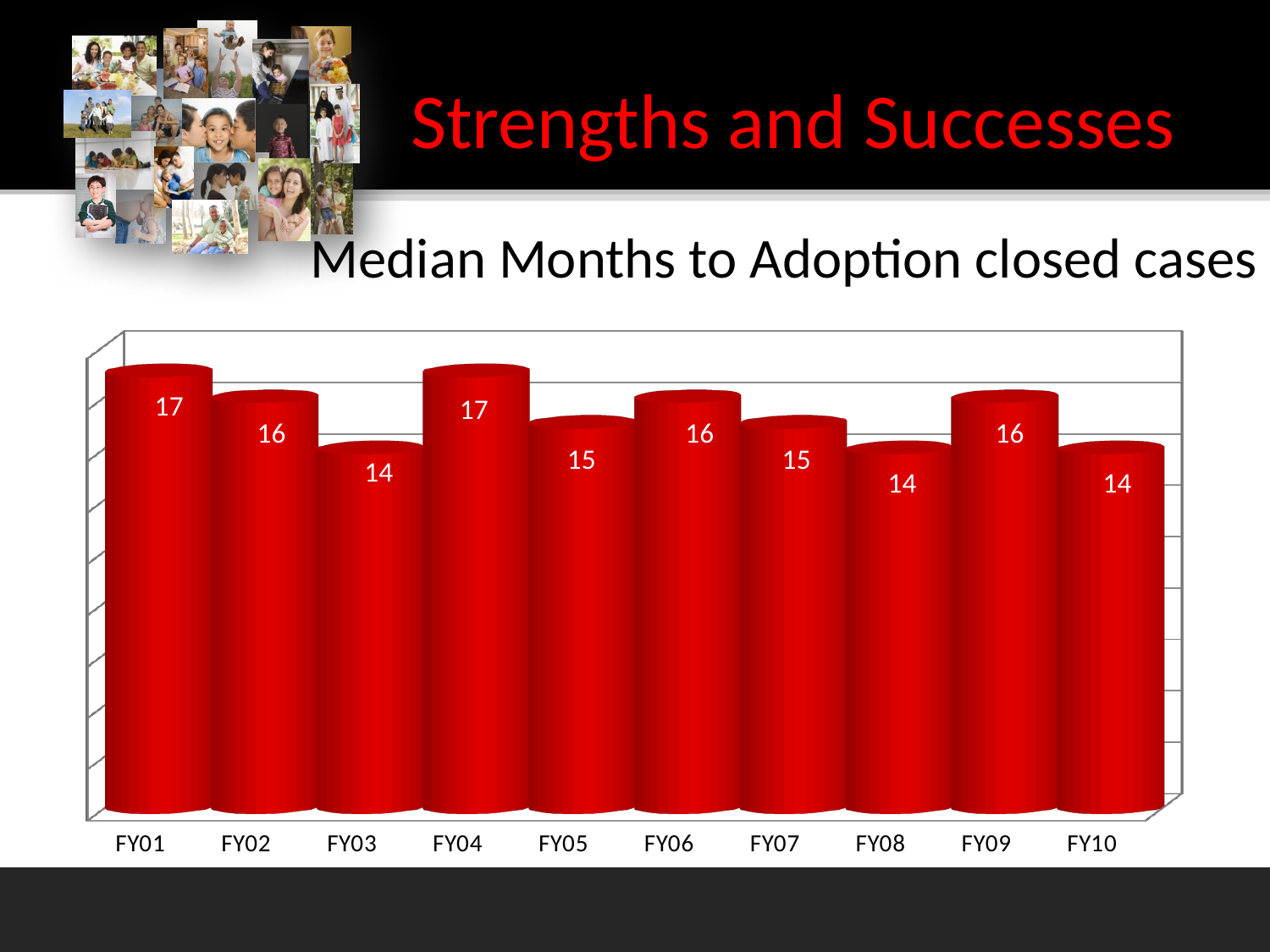
How many fiscal years are shown on the chart? 10 What is the highest value shown on the chart? 17 What is the difference between the values for FY04 and FY05? 2 Which has a larger value, FY02 or FY03? FY02 What kind of chart is shown on the slide? Bar chart What is the value for FY09? 16 What is the median months to adoption for FY01? 17 What value is shown for FY05? 15 What is the difference between the values for FY01 and FY03? 3 What value is shown for FY10? 14 What is the title of the chart? Median Months to Adoption closed cases What is the lowest value shown on the chart? 14